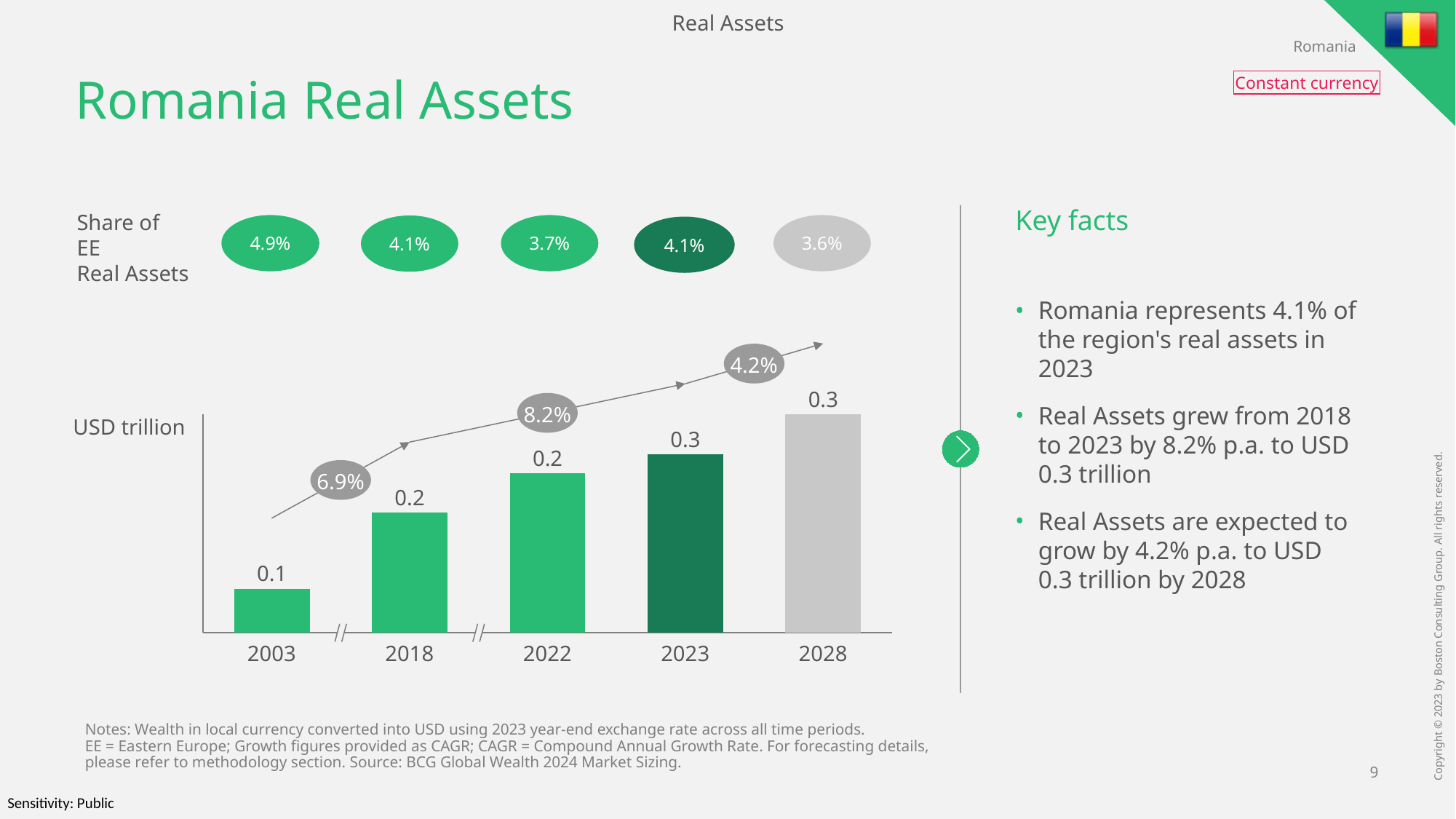
Which is larger in the Romania Real Assets chart, the value for 2003 or the value for 2023? 2023 Do the values in the Romania Real Assets chart rise or fall from 2003 to 2028? Rise What growth rate (CAGR) is shown between 2018 and 2023 in the Romania Real Assets chart? 8.2% How many years are shown on the x axis of the Romania Real Assets chart? 5 What is the value for 2023 in the Romania Real Assets chart? 0.3 What is the difference between the values for 2028 and 2003 in the Romania Real Assets chart? 0.2 Which year has the lowest value in the Romania Real Assets chart? 2003 What is the value for 2028 in the Romania Real Assets chart? 0.3 What is Romania's share of EE Real Assets shown for 2023? 4.1% What is Romania's share of EE Real Assets shown for 2003? 4.9% What kind of chart is used to show Romania Real Assets in USD trillion? Bar chart What is the value for 2003 in the Romania Real Assets chart? 0.1